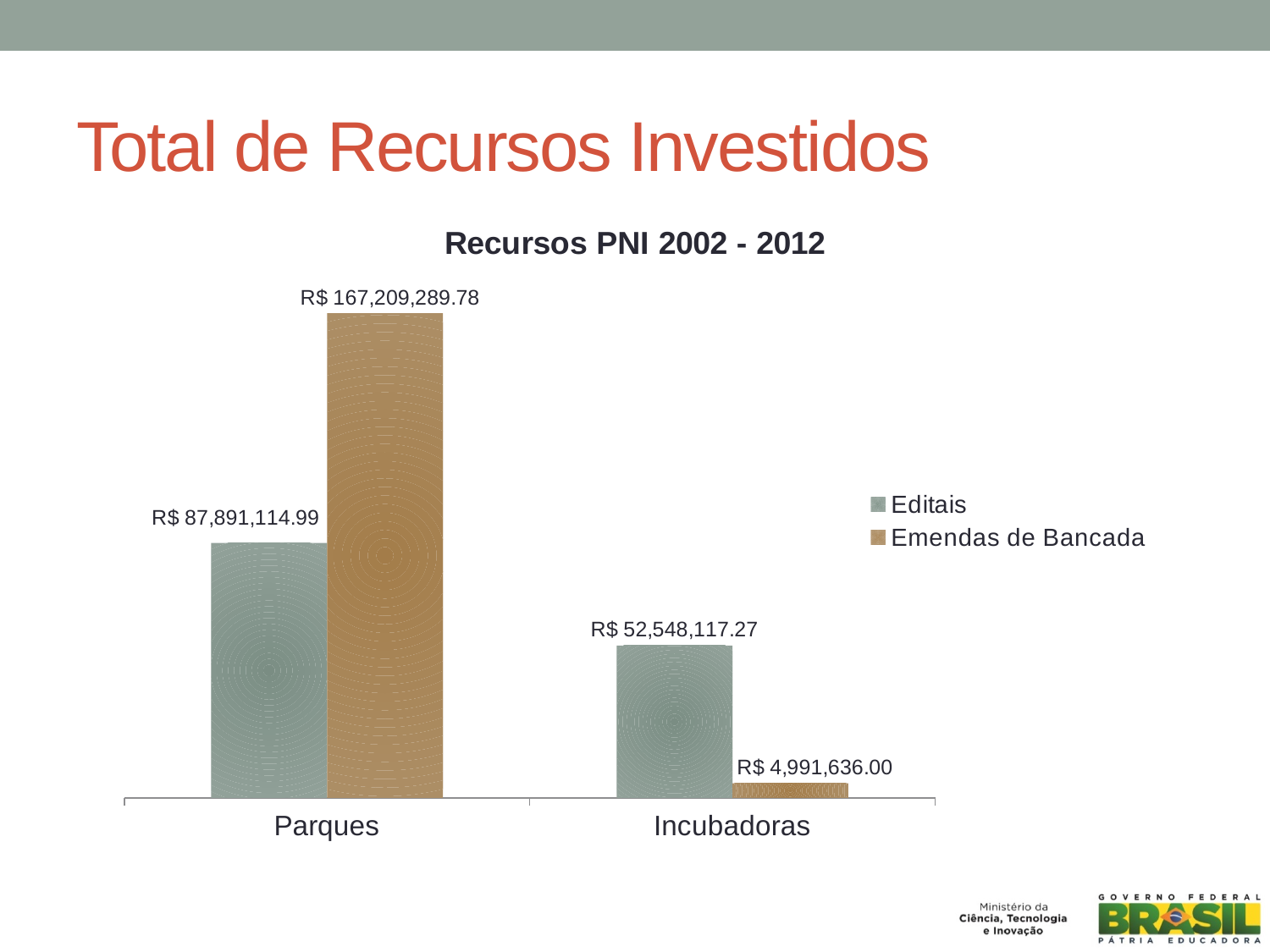
What is the value of Editais for Incubadoras? R$ 52,548,117.27 Which is larger for Incubadoras, Editais or Emendas de Bancada? Editais What is the value of Editais for Parques? R$ 87,891,114.99 How many categories are shown on the x axis? 2 Which bar has the highest value in the chart? Emendas de Bancada for Parques How many series does the legend list? 2 What is the difference between Emendas de Bancada and Editais for Parques? R$ 79,318,174.79 Which bar has the lowest value in the chart? Emendas de Bancada for Incubadoras What is the value of Emendas de Bancada for Parques? R$ 167,209,289.78 What is the title of the chart? Recursos PNI 2002 - 2012 What type of chart is shown on the slide? Bar chart What is the value of Emendas de Bancada for Incubadoras? R$ 4,991,636.00